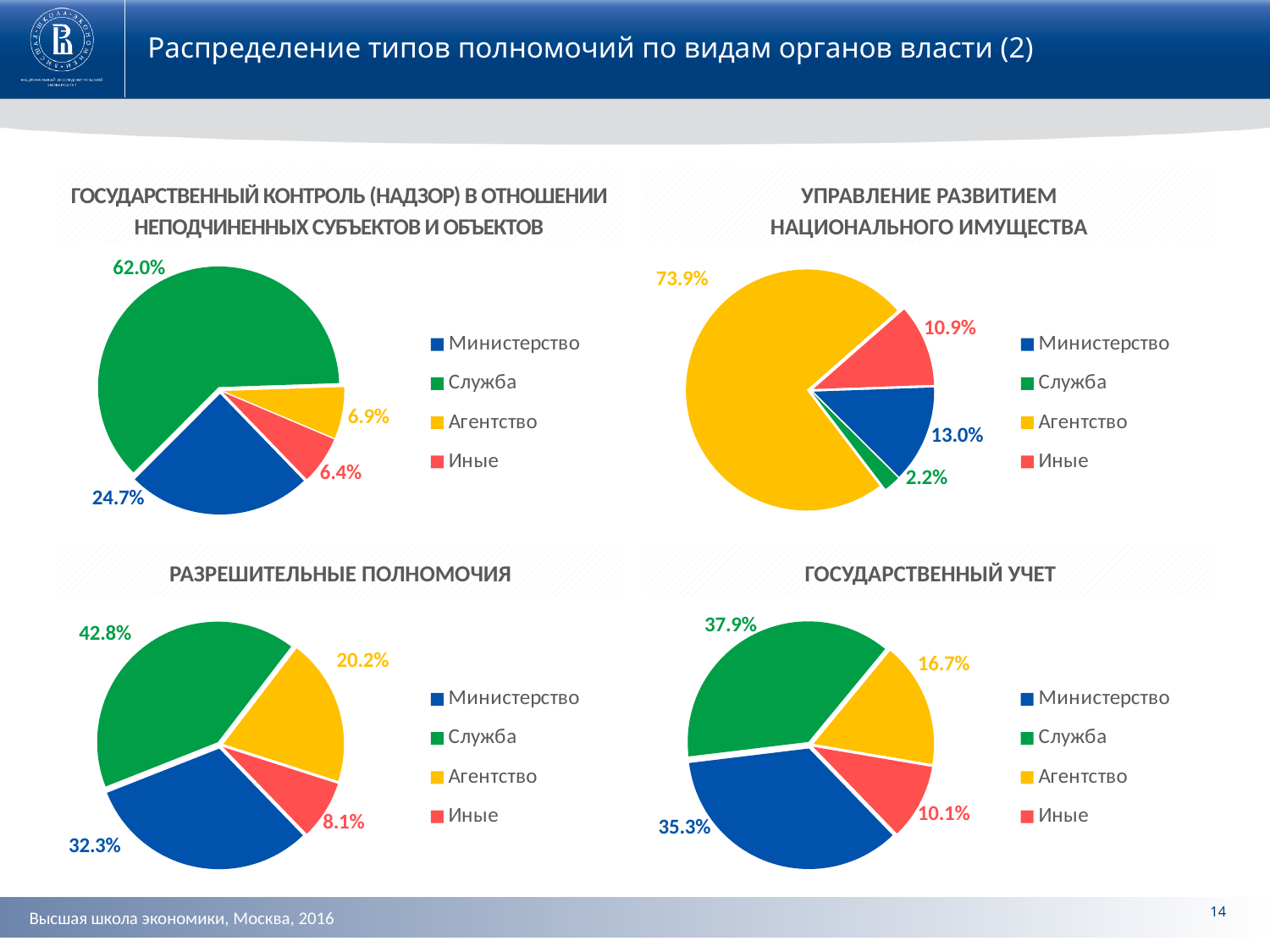
What type of chart is used for ГОСУДАРСТВЕННЫЙ УЧЕТ? Pie chart In the bottom-left chart (РАЗРЕШИТЕЛЬНЫЕ ПОЛНОМОЧИЯ), which is larger: the share of Служба or the share of Министерство? Служба In the bottom-left chart (РАЗРЕШИТЕЛЬНЫЕ ПОЛНОМОЧИЯ), which category has the smallest share? Иные In the top-right chart (УПРАВЛЕНИЕ РАЗВИТИЕМ НАЦИОНАЛЬНОГО ИМУЩЕСТВА), what share does Служба have? 2.2% In the bottom-right chart (ГОСУДАРСТВЕННЫЙ УЧЕТ), what is the difference between the shares of Агентство and Иные? 6.6% How many categories does the legend of the top-left chart list? 4 In the top-right chart (УПРАВЛЕНИЕ РАЗВИТИЕМ НАЦИОНАЛЬНОГО ИМУЩЕСТВА), what is the difference between the shares of Министерство and Иные? 2.1% In the top-left chart (ГОСУДАРСТВЕННЫЙ КОНТРОЛЬ (НАДЗОР)...), what share does Служба have? 62.0% In the top-left chart (ГОСУДАРСТВЕННЫЙ КОНТРОЛЬ (НАДЗОР)...), what share does Министерство have? 24.7% In the bottom-right chart (ГОСУДАРСТВЕННЫЙ УЧЕТ), what share does Министерство have? 35.3% In the top-right chart (УПРАВЛЕНИЕ РАЗВИТИЕМ НАЦИОНАЛЬНОГО ИМУЩЕСТВА), which category has the largest share? Агентство In the bottom-left chart (РАЗРЕШИТЕЛЬНЫЕ ПОЛНОМОЧИЯ), what share does Агентство have? 20.2%